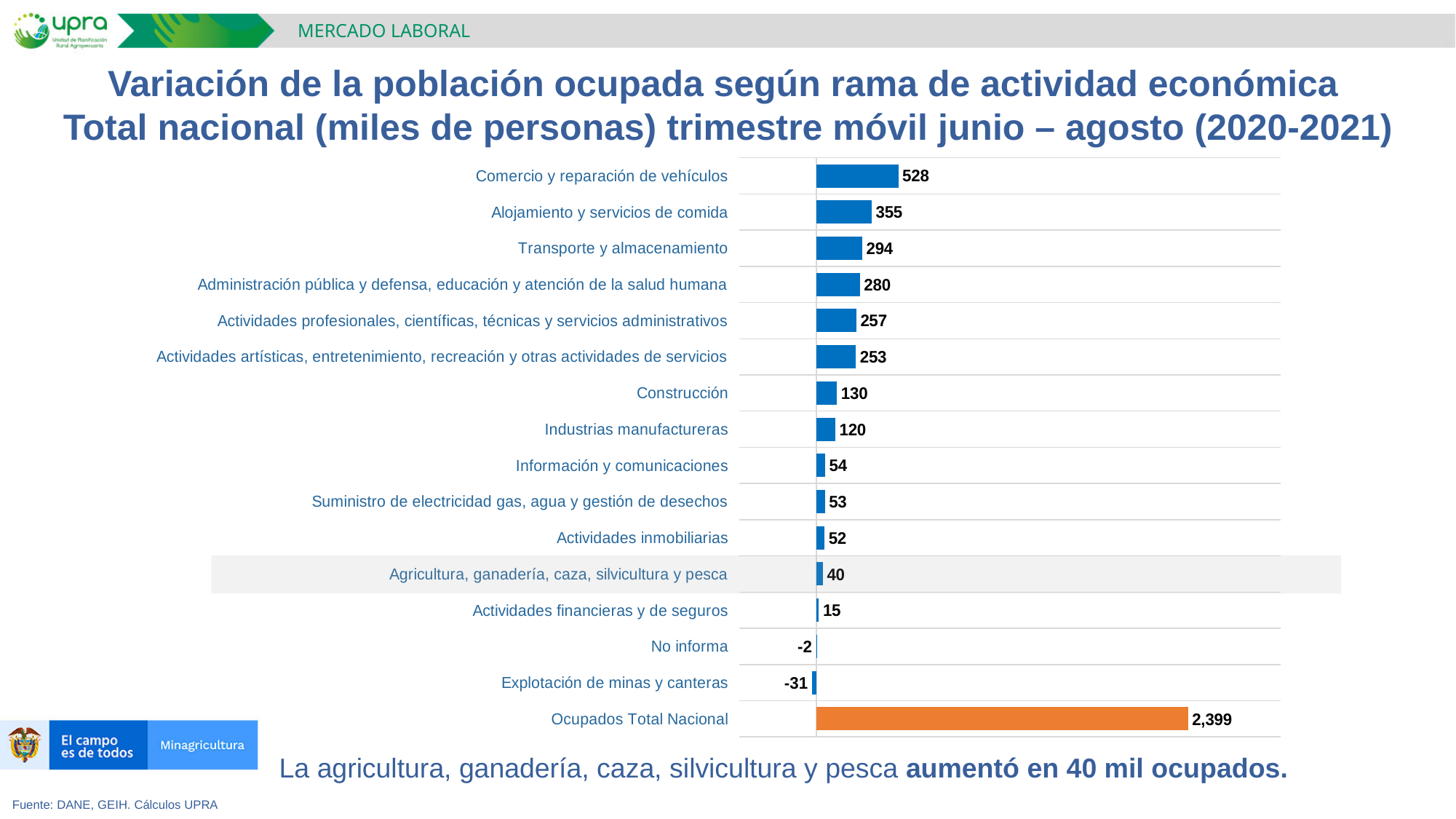
Which bar is shown in orange rather than blue? Ocupados Total Nacional Excluding Ocupados Total Nacional, which category has the highest value? Comercio y reparación de vehículos Which is larger, the value for Construcción or the value for Industrias manufactureras? Construcción What is the value for No informa? -2 What is the value for Agricultura, ganadería, caza, silvicultura y pesca? 40 What is the difference between the values for Comercio y reparación de vehículos and Alojamiento y servicios de comida? 173 Which category has the lowest value? Explotación de minas y canteras What is the value for Explotación de minas y canteras? -31 How many categories are shown in the chart? 16 What is the value for Comercio y reparación de vehículos? 528 What kind of chart is shown on the slide? Bar chart What is the value for Ocupados Total Nacional? 2,399